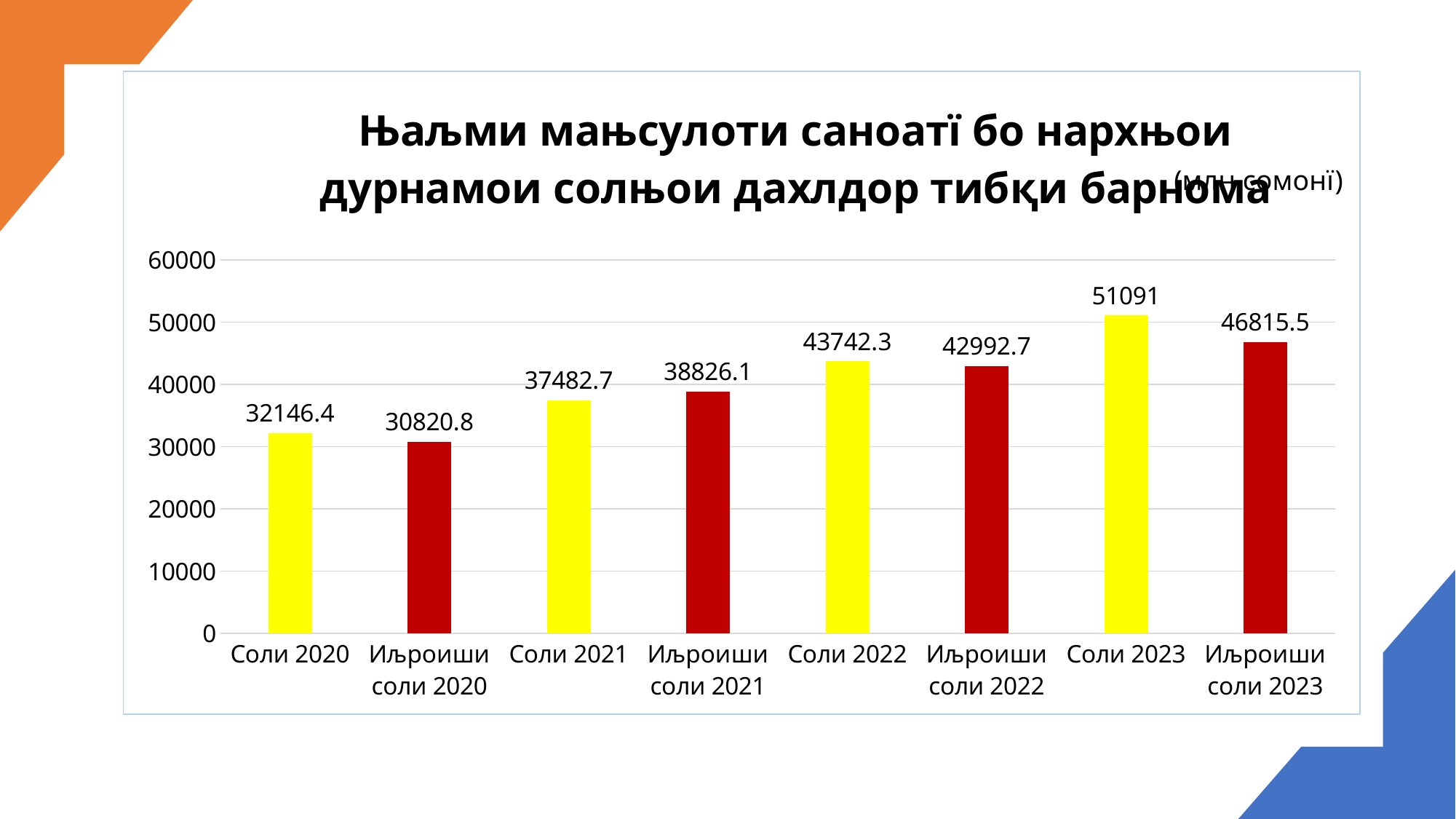
What is the value for Соли 2023? 51091 What is the difference between the values for Иљроиши соли 2021 and Соли 2021? 1343.4 Which category has the lowest value? Иљроиши соли 2020 What is the difference between the values for Соли 2023 and Иљроиши соли 2023? 4275.5 How many bars are shown in the chart? 8 What is the value for Соли 2020? 32146.4 What unit is indicated in parentheses at the top right of the chart? млн сомонї Is the value for Иљроиши соли 2023 greater or less than 40000? greater What is the value for Иљроиши соли 2022? 42992.7 Which is larger, the value for Соли 2022 or the value for Иљроиши соли 2022? Соли 2022 What kind of chart is shown on the slide? bar chart Which category has the highest value? Соли 2023